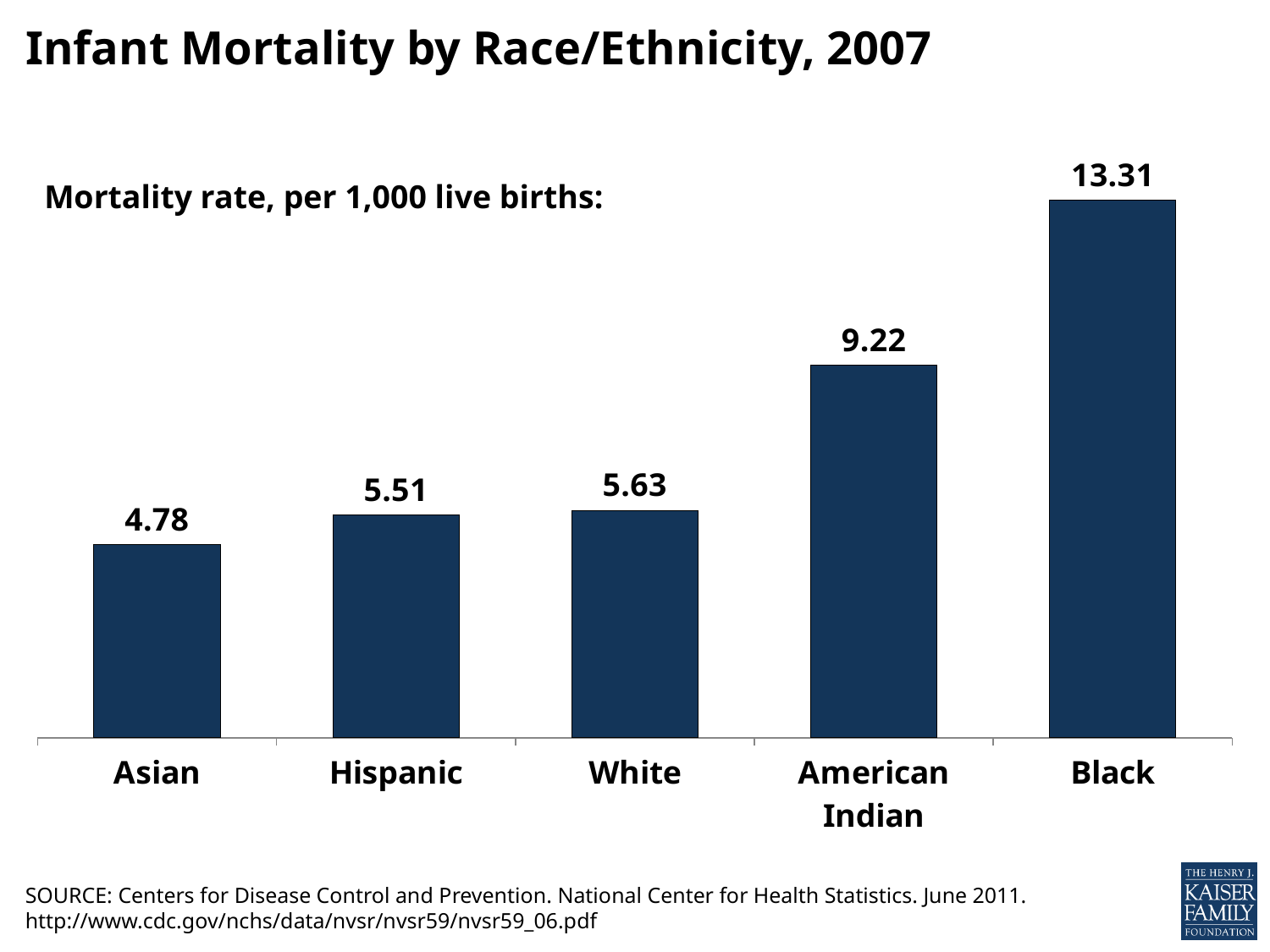
What is the infant mortality rate for American Indian infants? 9.22 In what unit are the mortality rates expressed, according to the chart label? Per 1,000 live births What is the infant mortality rate for Black infants? 13.31 What is the infant mortality rate for Hispanic infants? 5.51 What is the difference between the infant mortality rates for Black and White infants? 7.68 Which has a higher infant mortality rate, White or Hispanic? White What is the infant mortality rate for Asian infants? 4.78 Which race/ethnicity has the lowest infant mortality rate? Asian What is the difference between the infant mortality rates for American Indian and Hispanic infants? 3.71 Which race/ethnicity has the highest infant mortality rate? Black How many race/ethnicity categories are shown in the chart? 5 What type of chart is shown on the slide? Bar chart